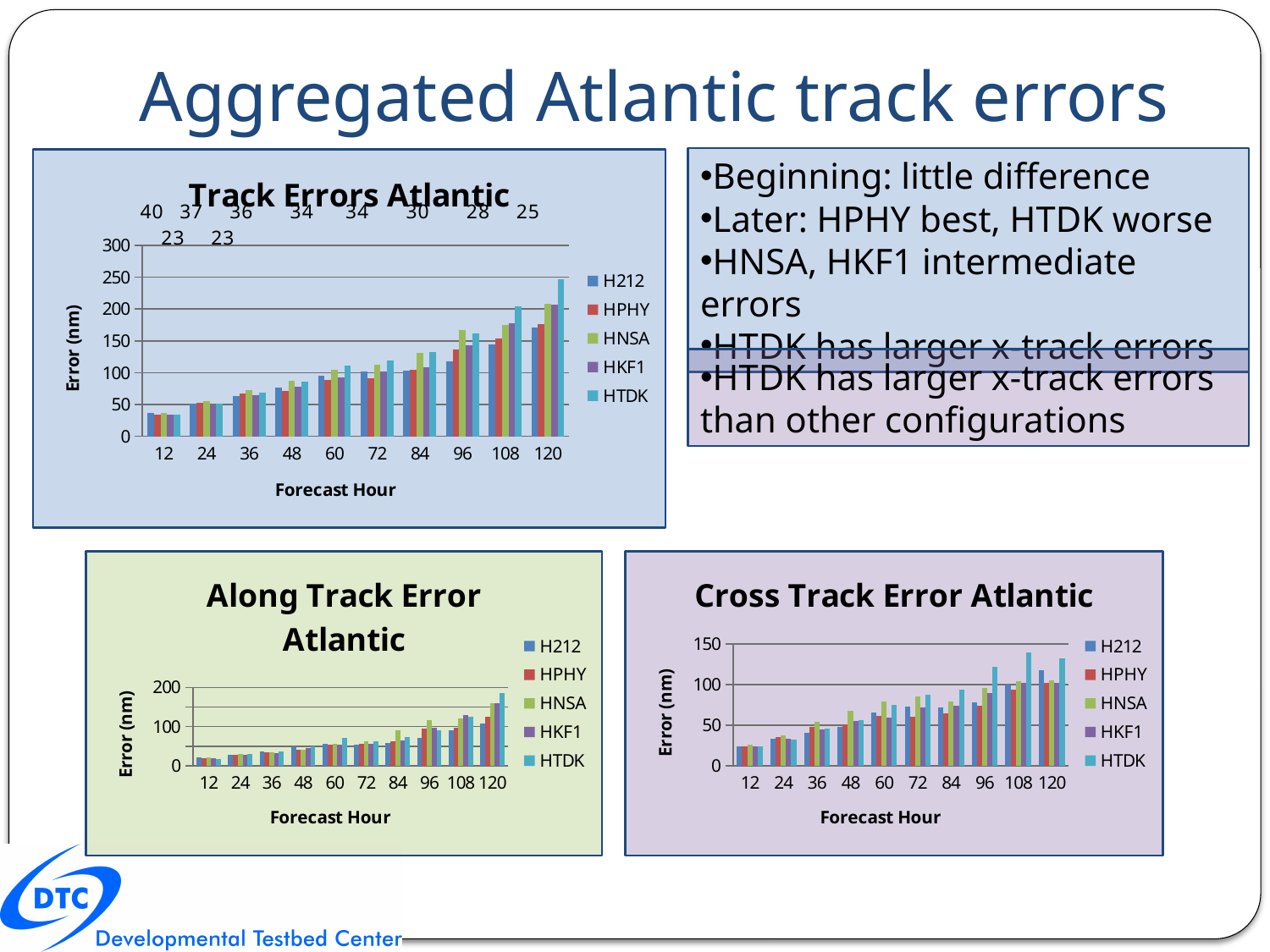
In the 'Cross Track Error Atlantic' chart, is the HTDK value at forecast hour 108 greater or less than 100? greater In the 'Along Track Error Atlantic' chart, is the HTDK value at forecast hour 120 greater or less than 100? greater In the 'Track Errors Atlantic' chart, is the HPHY value at forecast hour 120 greater or less than 200? less How many series does the legend of the 'Track Errors Atlantic' chart list? 5 What kind of chart is the 'Track Errors Atlantic' chart? bar chart What is the label of the y axis on the 'Cross Track Error Atlantic' chart? Error (nm) In the 'Track Errors Atlantic' chart, at forecast hour 120, which is larger: HTDK or HPHY? HTDK In the 'Track Errors Atlantic' chart, which series has the highest value at forecast hour 120? HTDK How many forecast hours are shown on the x axis of the 'Cross Track Error Atlantic' chart? 10 In the 'Track Errors Atlantic' chart, do the errors generally rise or fall as the forecast hour increases? rise In the 'Cross Track Error Atlantic' chart, at forecast hour 96, which is larger: HTDK or HPHY? HTDK